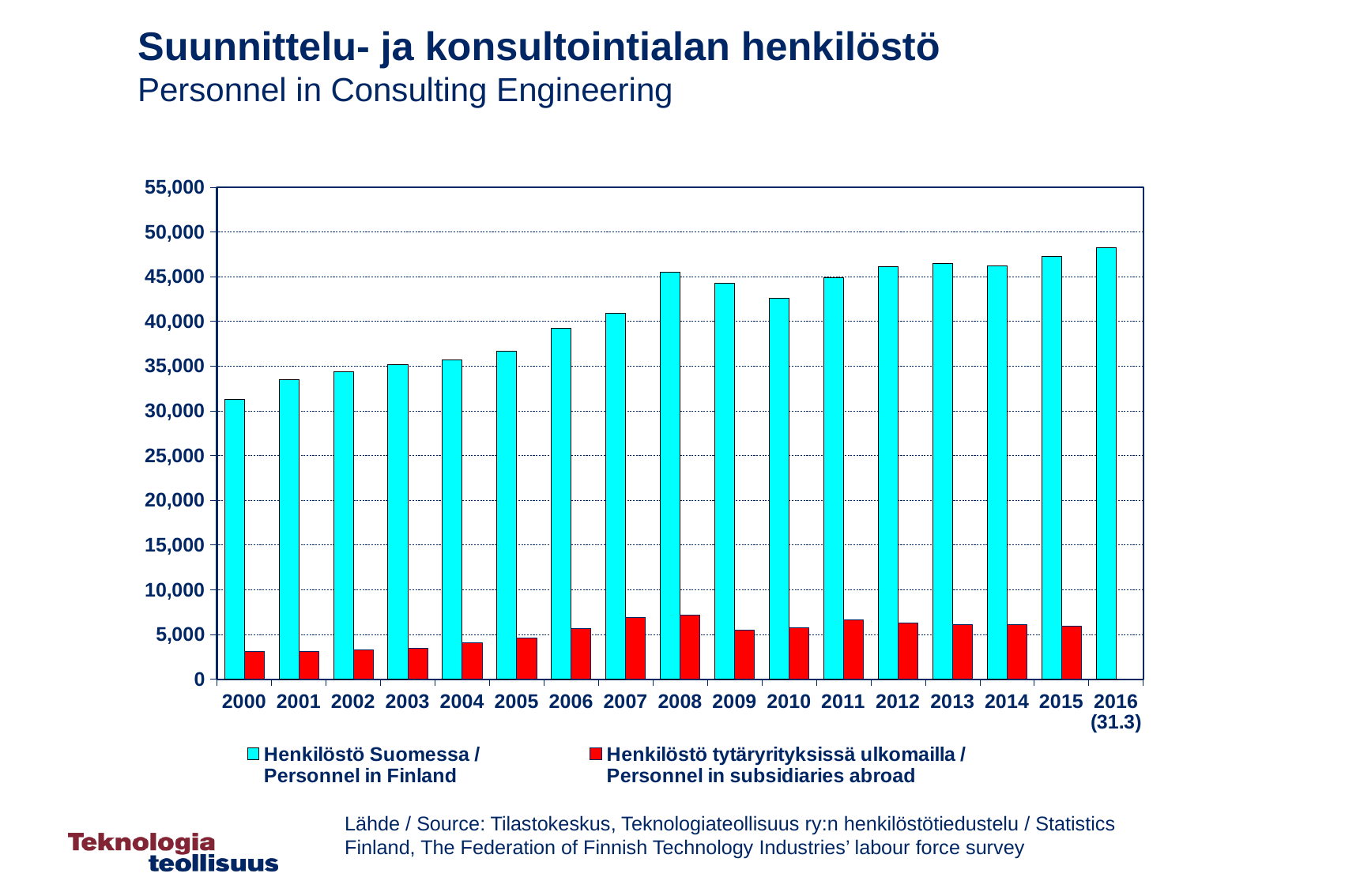
What kind of chart is shown on the slide? bar chart Is the value for Personnel in subsidiaries abroad in 2008 greater or less than 5,000? greater Which is larger for Personnel in Finland, 2008 or 2009? 2008 Is the value for Personnel in Finland in 2000 greater or less than 30,000? greater Which year has the lowest value for Personnel in Finland? 2000 Which year has the highest value for Personnel in subsidiaries abroad? 2008 Is the value for Personnel in Finland in 2010 greater or less than 45,000? less Does the value for Personnel in Finland generally rise or fall from 2000 to 2016? rise How many series does the legend list? 2 How many years are shown along the x axis? 17 Which year has the highest value for Personnel in Finland? 2016 (31.3)